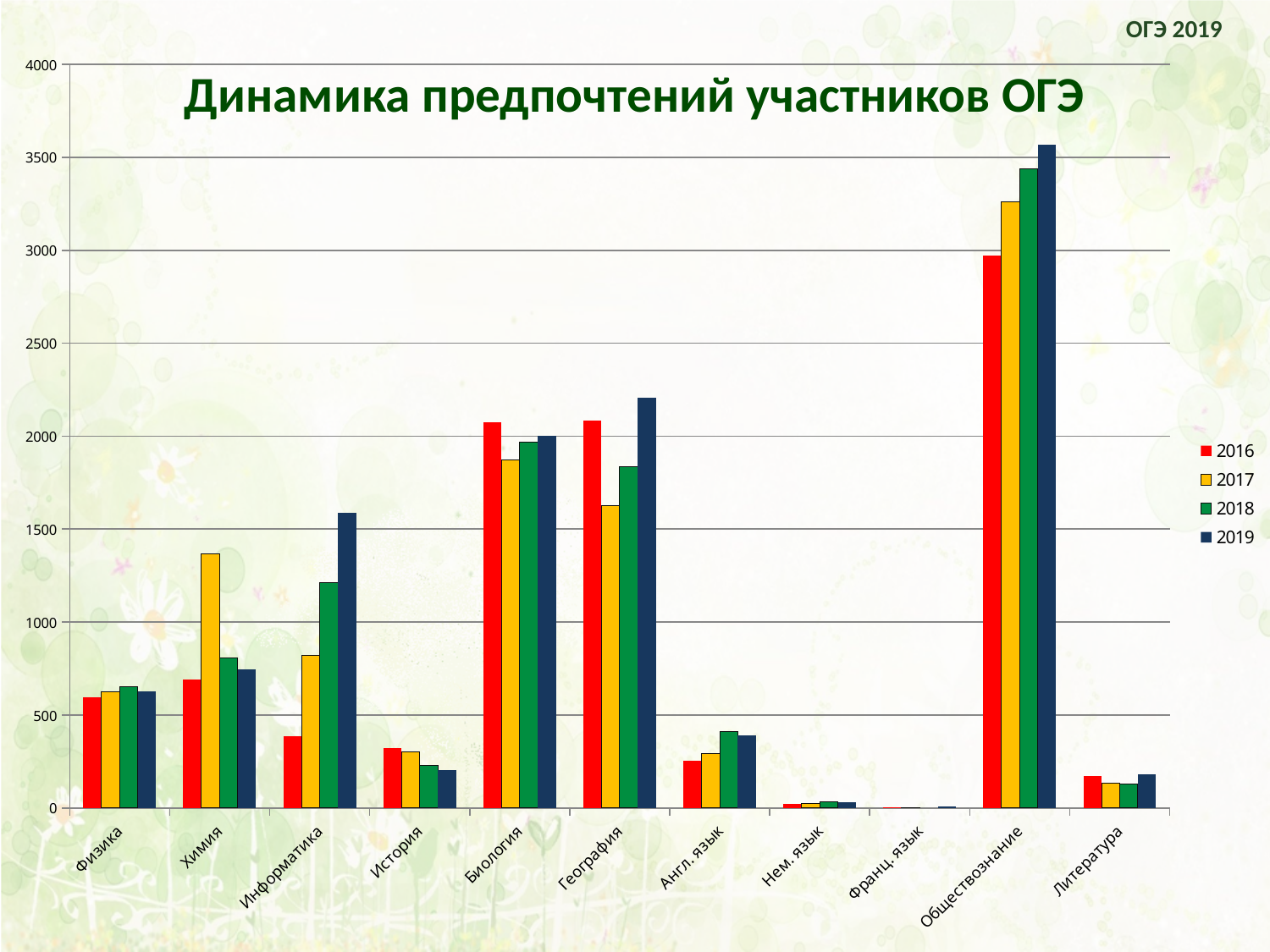
For Обществознание, do the values rise or fall from 2016 to 2019? rise What kind of chart is shown on the slide? bar chart How many subject categories are shown on the x axis? 11 Which subject has the highest value for 2019? Обществознание Is the value for История in 2019 greater or less than 500? less What is the title of the chart? Динамика предпочтений участников ОГЭ Which subject has the lowest value for 2019? Франц. язык Is the value for География in 2019 greater or less than 2000? greater How many series does the legend list? 4 Is the value for Обществознание in 2016 greater or less than 2500? greater For Химия, which is larger: the value for 2017 or the value for 2019? 2017